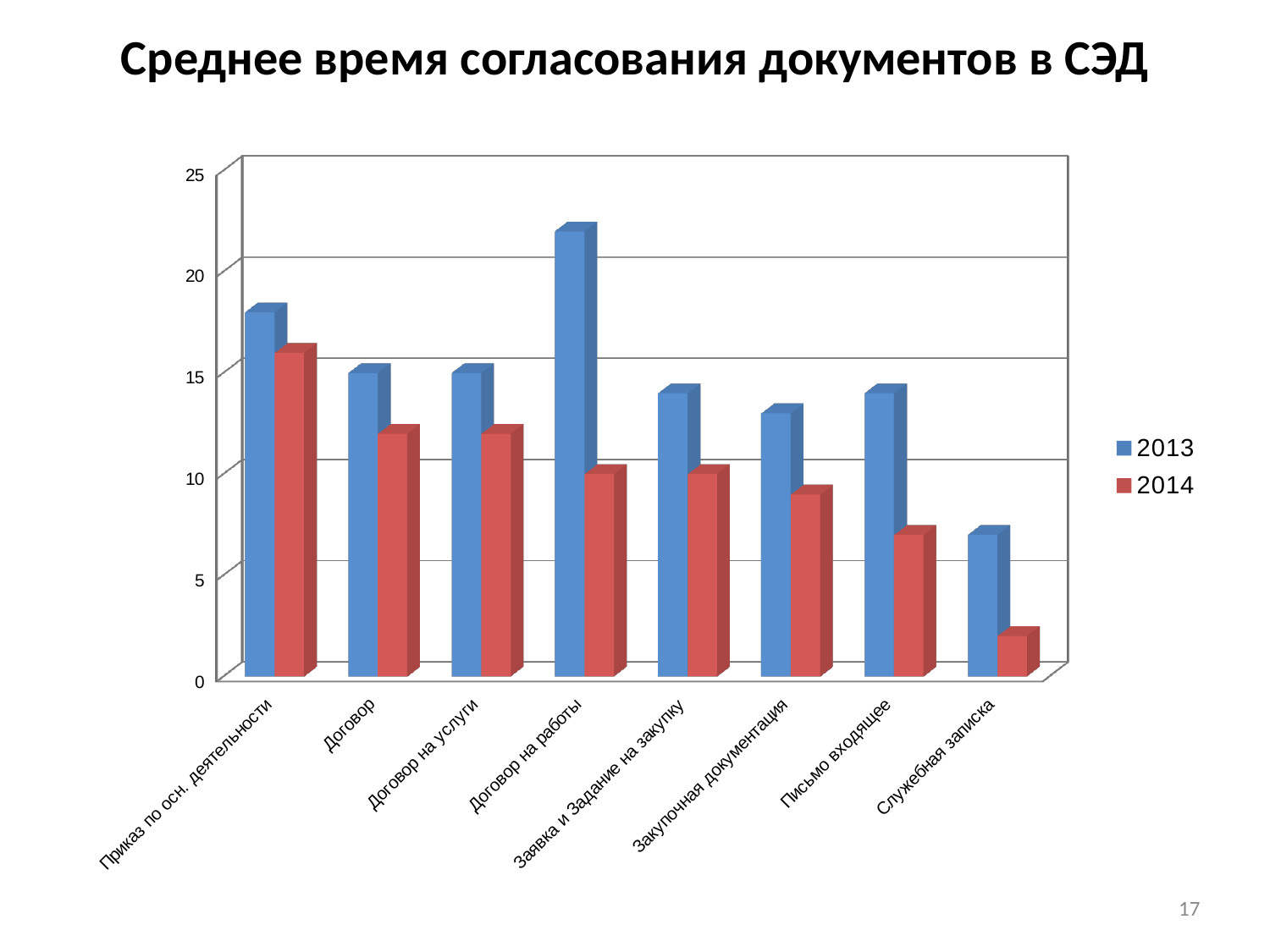
What kind of chart is shown on the slide? bar chart Is the 2013 value for Договор на работы greater or less than 20? greater What is the title of the chart on the slide? Среднее время согласования документов в СЭД Is the 2014 value for Служебная записка greater or less than 5? less Which category has the highest value for 2014? Приказ по осн. деятельности How many series does the legend list? 2 Which category has the highest value for 2013? Договор на работы For Договор на работы, which series has the larger value, 2013 or 2014? 2013 How many document categories are shown on the x axis? 8 Is the 2014 value for Письмо входящее greater or less than 10? less Which category has the lowest value for 2014? Служебная записка Which category has the lowest value for 2013? Служебная записка